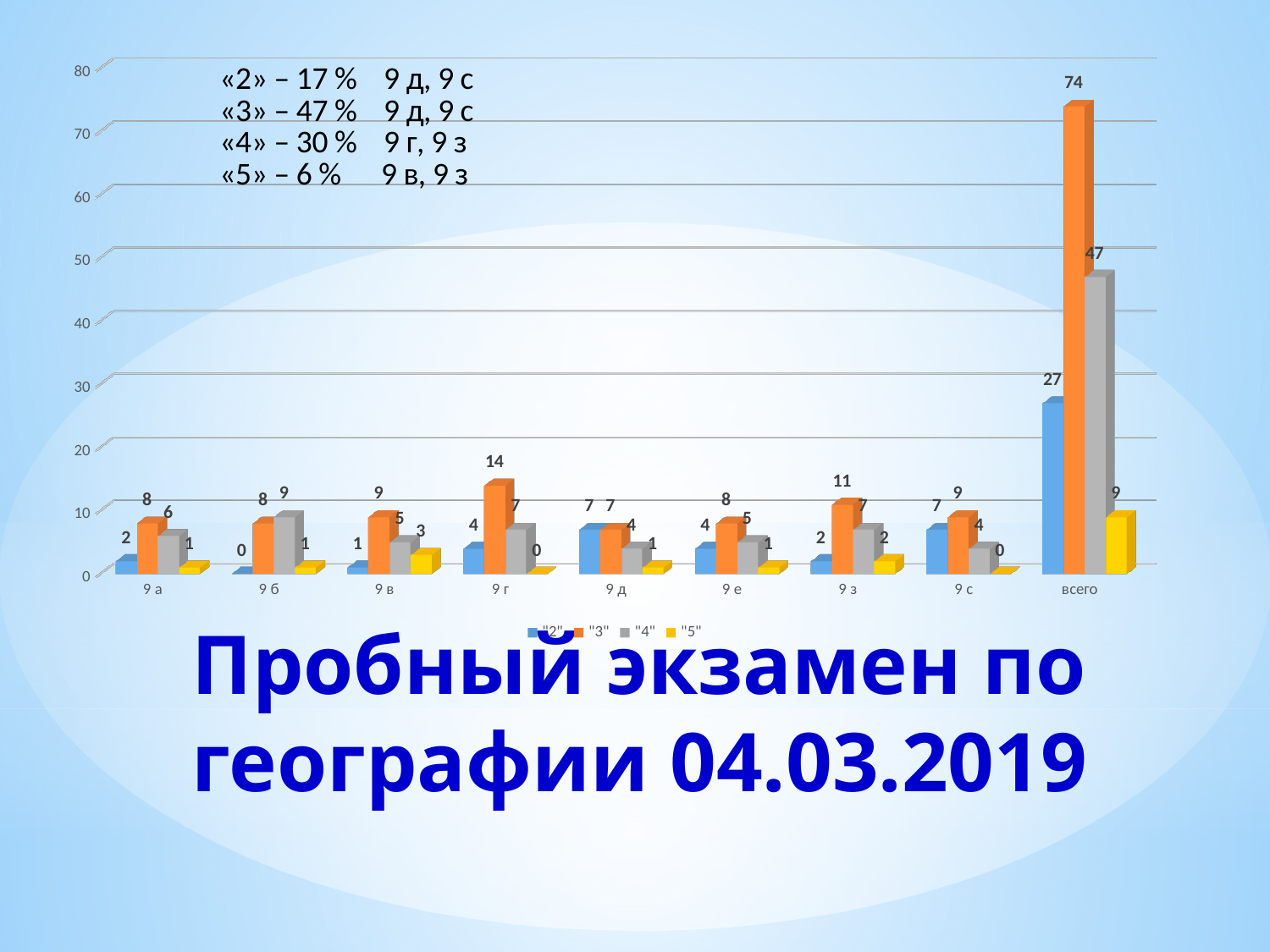
Which is larger for 9 з: the value of series "3" or the value of series "4"? series "3" Which category has the lowest value for series "2"? 9 б How many categories are shown on the x axis? 9 What is the value of series "5" for the category 9 в? 3 How many series does the legend list? 4 What is the difference between the series "3" value and the series "4" value for всего? 27 Excluding всего, which category has the highest value for series "3"? 9 г What is the value of series "4" for the category 9 б? 9 What is the value of series "3" for the category всего? 74 What is the value of series "2" for the category 9 д? 7 What kind of chart is shown on the slide? bar chart What is the total of the four series values for the category 9 г? 25